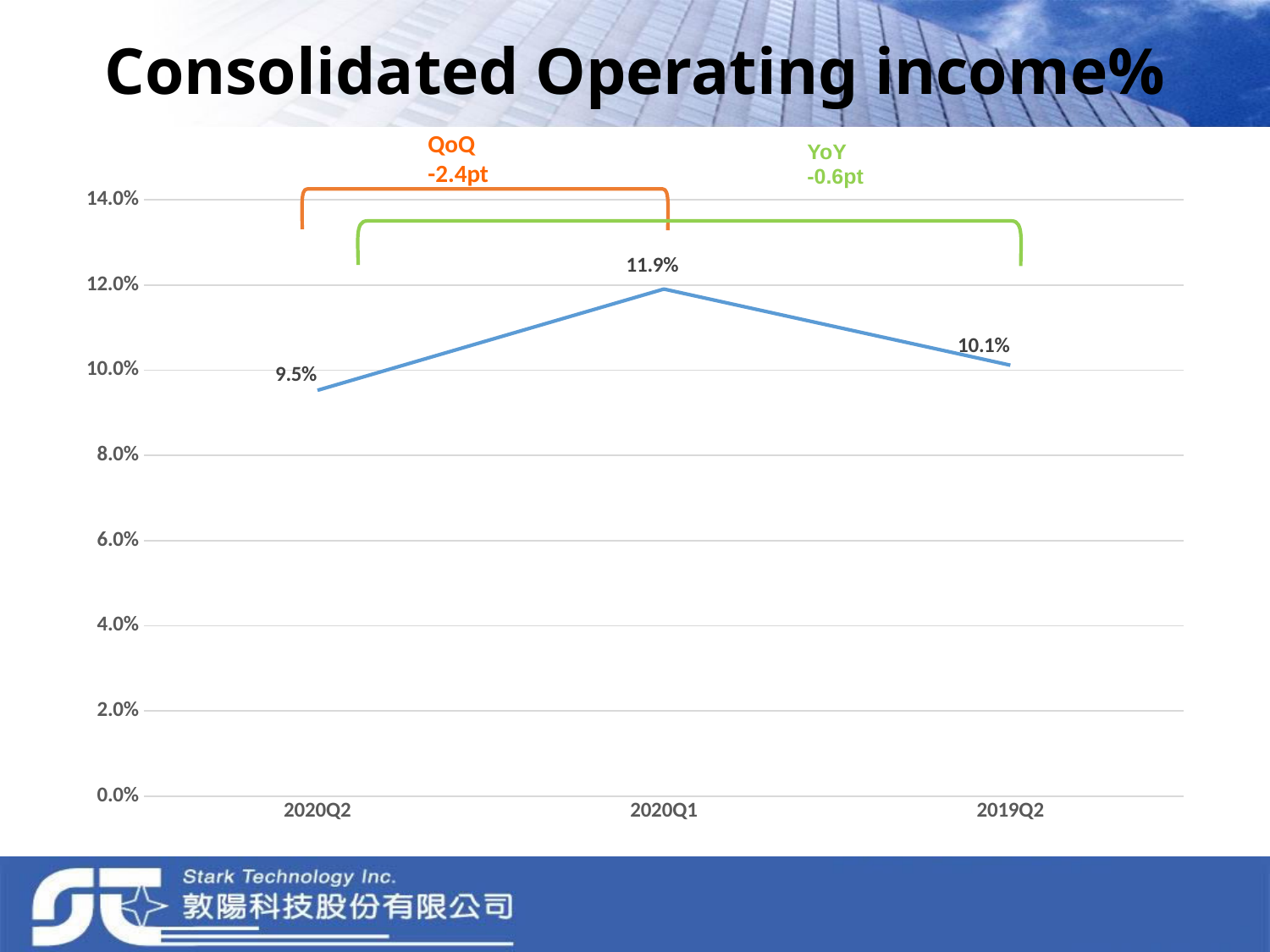
What is the consolidated operating income % for 2020Q2? 9.5% How many periods are plotted on the chart? 3 What is the difference in operating income % between 2020Q1 and 2020Q2? 2.4 percentage points Which period has the lowest consolidated operating income %? 2020Q2 Which is larger, the operating income % for 2019Q2 or for 2020Q2? 2019Q2 What is the consolidated operating income % for 2019Q2? 10.1% Which period has the highest consolidated operating income %? 2020Q1 What is the consolidated operating income % for 2020Q1? 11.9% What is the difference in operating income % between 2019Q2 and 2020Q2? 0.6 percentage points Is the operating income % for 2020Q1 greater or less than 10.0%? greater What type of chart is shown on the slide? Line chart What QoQ change is annotated on the chart? -2.4pt